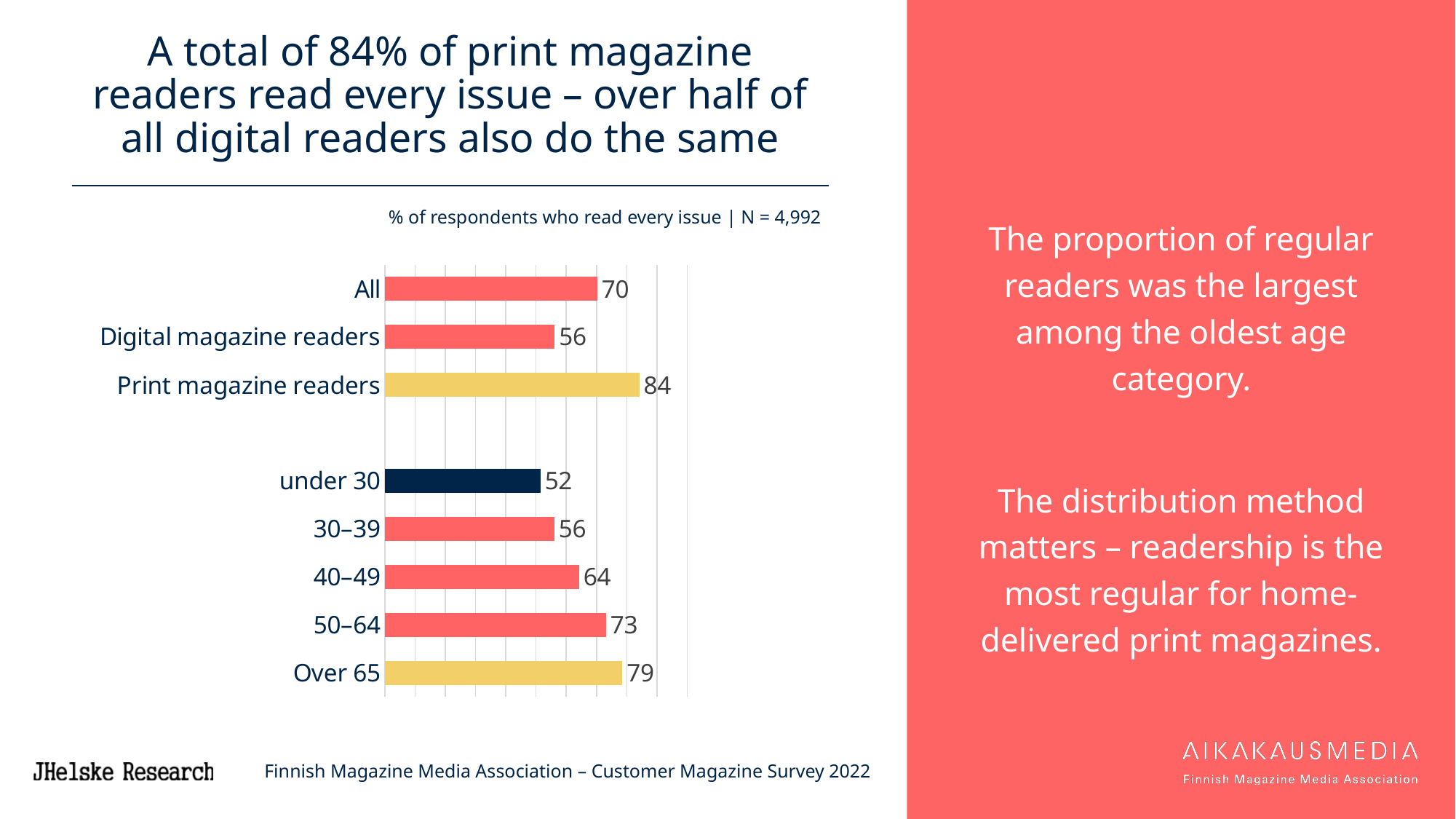
Which category has the lowest value in the chart? under 30 Which category has the highest value in the chart? Print magazine readers How many categories are plotted in the chart? 8 What is the value for the Over 65 age group? 79 What is the difference between the values for Print magazine readers and Digital magazine readers? 28 What is the value for Digital magazine readers? 56 What is the difference between the values for Over 65 and under 30? 27 What kind of chart is shown on the slide? Bar chart What is the value for Print magazine readers? 84 Do the values rise or fall across the age groups from under 30 to Over 65? Rise What is the value for the under 30 age group? 52 Which is larger, the value for 50–64 or the value for 40–49? 50–64